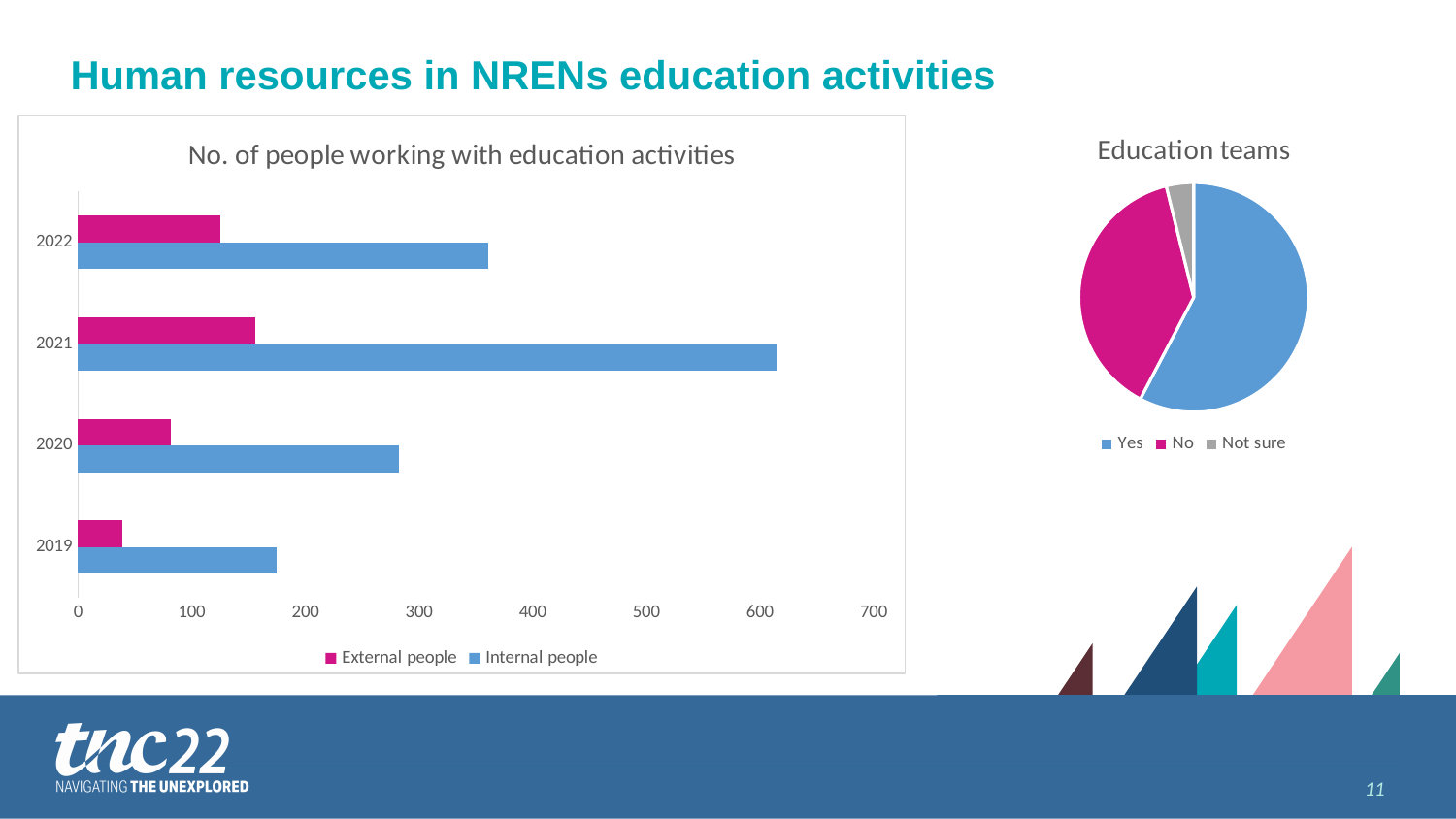
In the chart 'No. of people working with education activities', which year has the lowest value for External people? 2019 In the chart 'No. of people working with education activities', which is larger: Internal people in 2022 or Internal people in 2020? Internal people in 2022 In the chart 'No. of people working with education activities', is the value for External people in 2020 greater or less than 100? less In the 'Education teams' pie chart, which category has the smallest slice? Not sure In the chart 'No. of people working with education activities', do the values for External people rise or fall from 2019 to 2021? rise In the 'Education teams' pie chart, which category has the largest slice? Yes What kind of chart is 'Education teams'? pie chart What kind of chart is 'No. of people working with education activities'? bar chart In the chart 'No. of people working with education activities', which year has the highest value for Internal people? 2021 In the chart 'No. of people working with education activities', how many series does the legend list? 2 In the chart 'No. of people working with education activities', is the value for Internal people in 2021 greater or less than 600? greater In the chart 'No. of people working with education activities', how many years are shown on the vertical axis? 4